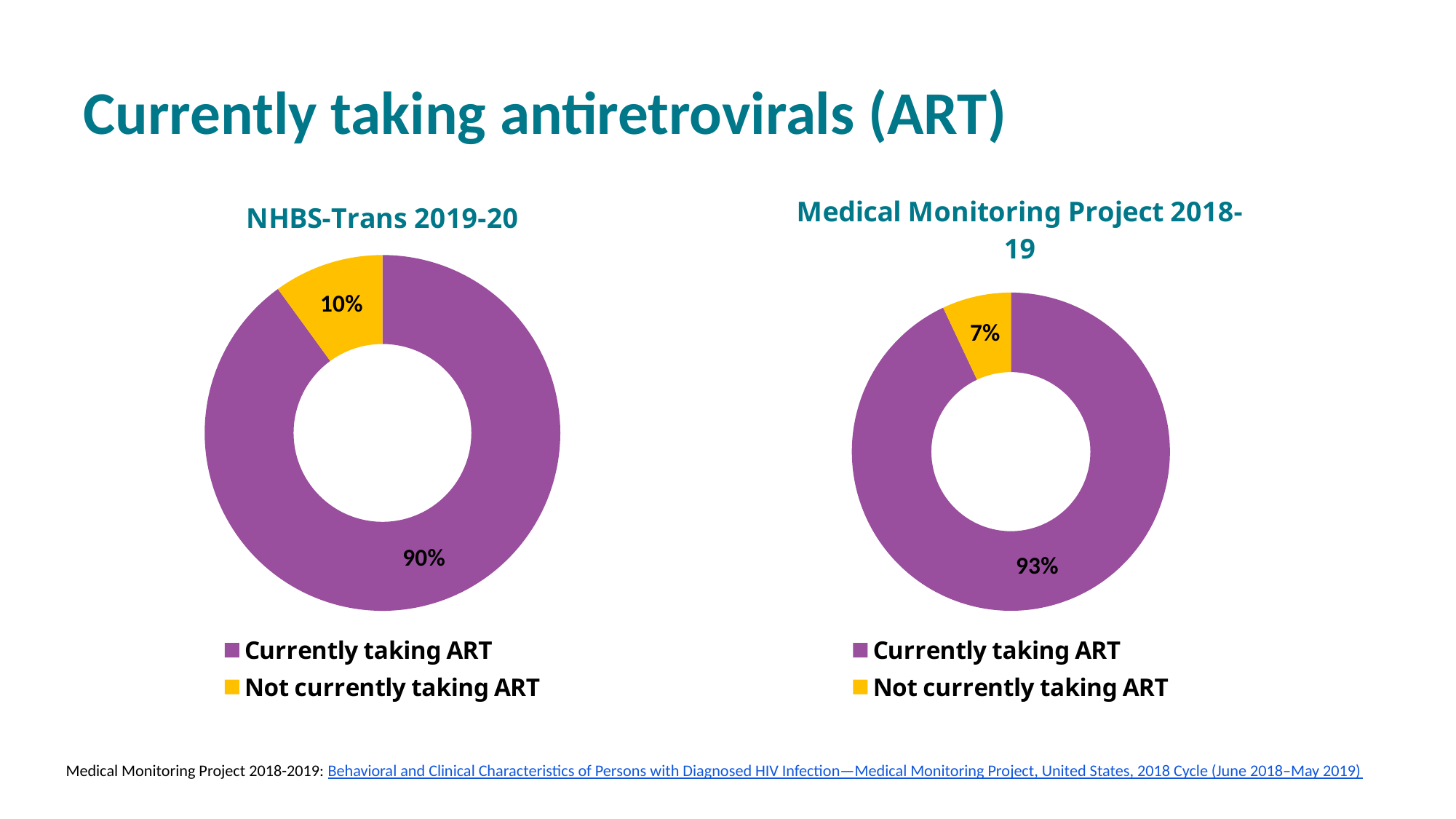
What type of chart is the NHBS-Trans 2019-20 chart? Doughnut chart In the NHBS-Trans 2019-20 chart, which category has the largest share? Currently taking ART In the Medical Monitoring Project 2018-19 chart, what colour represents 'Not currently taking ART'? Yellow In the Medical Monitoring Project 2018-19 chart, what percentage are not currently taking ART? 7% How many categories does the Medical Monitoring Project 2018-19 chart show? 2 In the NHBS-Trans 2019-20 chart, what percentage are currently taking ART? 90% In the Medical Monitoring Project 2018-19 chart, which category has the smallest share? Not currently taking ART In the Medical Monitoring Project 2018-19 chart, what percentage are currently taking ART? 93% What is the difference between the 'Currently taking ART' share in the Medical Monitoring Project 2018-19 chart and in the NHBS-Trans 2019-20 chart? 3% In the NHBS-Trans 2019-20 chart, what percentage are not currently taking ART? 10% Which chart shows a larger share not currently taking ART, NHBS-Trans 2019-20 or Medical Monitoring Project 2018-19? NHBS-Trans 2019-20 How many entries does the legend of the NHBS-Trans 2019-20 chart list? 2